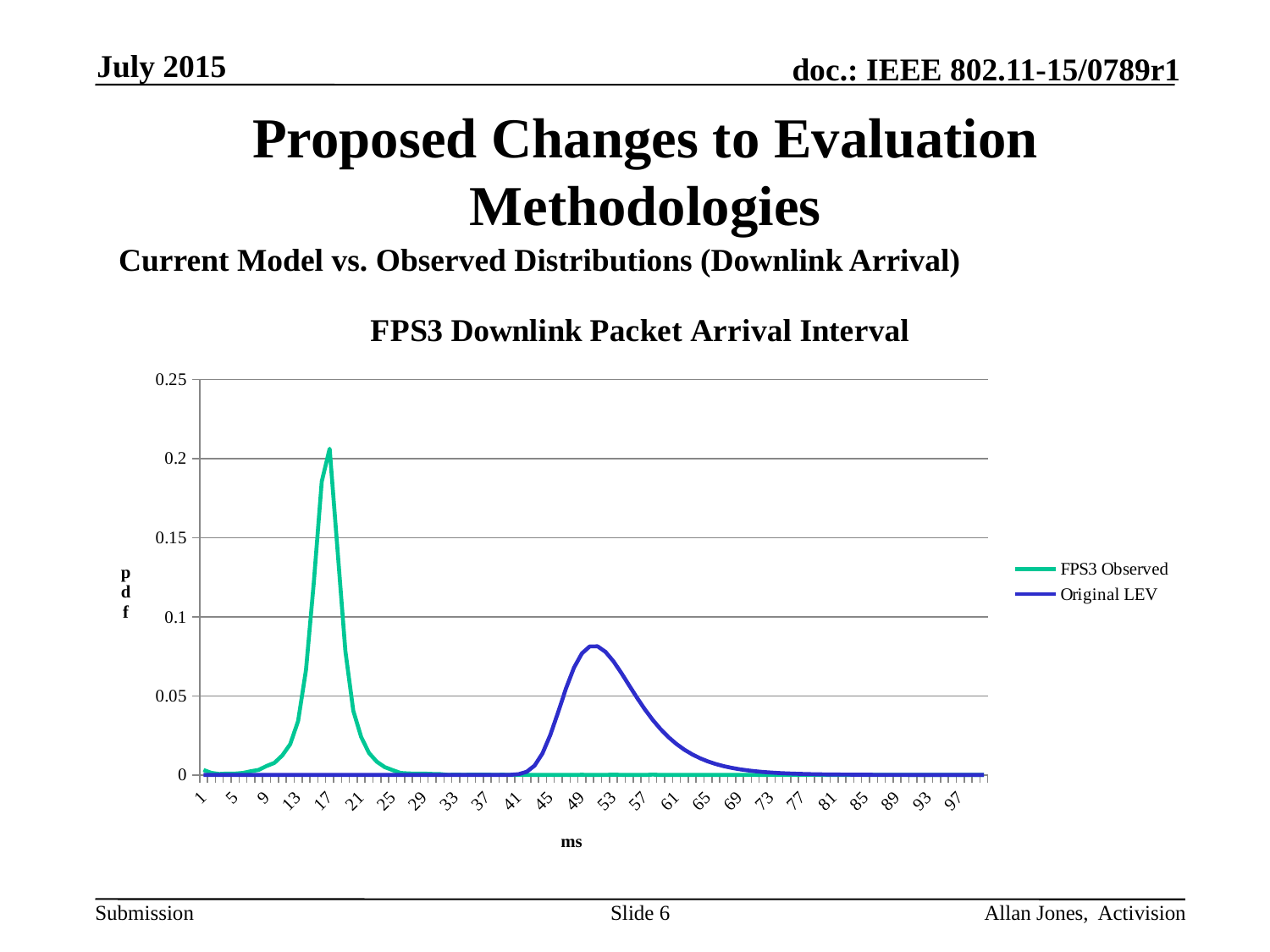
Does the FPS3 Observed series rise or fall between 9 ms and 17 ms? rise Which series reaches the higher peak value, FPS3 Observed or Original LEV? FPS3 Observed What kind of chart is shown on the slide? line chart Which series has its peak at a larger ms value, FPS3 Observed or Original LEV? Original LEV What are the two series named in the legend? FPS3 Observed and Original LEV How many series does the legend list? 2 Is the peak value of the FPS3 Observed series greater or less than 0.15? greater Is the peak value of the Original LEV series greater or less than 0.05? greater Is the value of the FPS3 Observed series at 49 ms greater or less than 0.05? less Does the Original LEV series rise or fall between 53 ms and 69 ms? fall What is the title of the chart? FPS3 Downlink Packet Arrival Interval